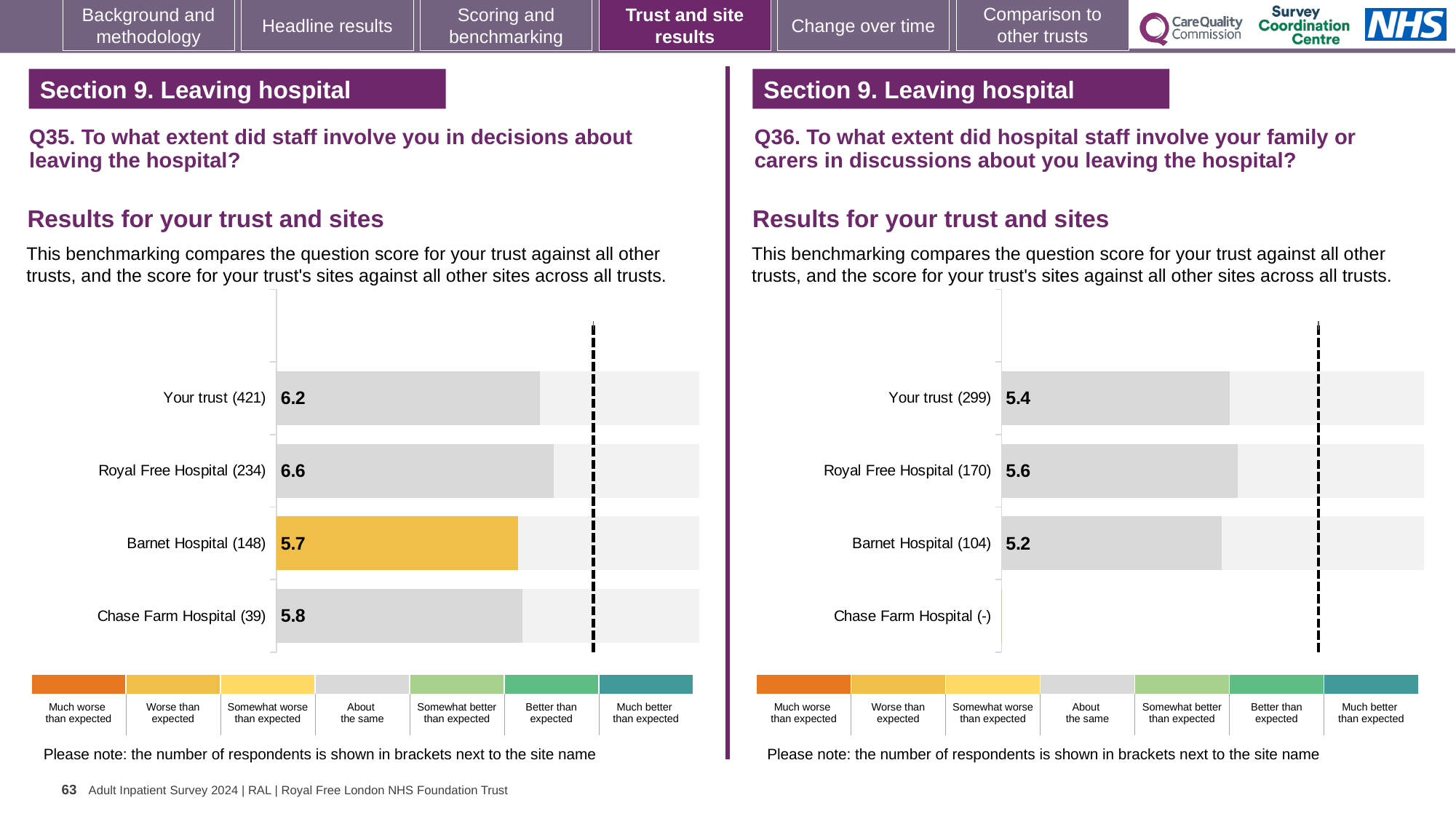
In the Q36 chart on the right, what is the score for Royal Free Hospital? 5.6 In the Q36 chart on the right, how many respondents are shown in brackets for Your trust? 299 In the Q35 chart on the left, what is the score for Barnet Hospital? 5.7 In the Q35 chart on the left, what is the difference between the scores for Royal Free Hospital and Barnet Hospital? 0.9 In the Q36 chart on the right, which of the plotted sites or trust has the lowest score? Barnet Hospital What type of chart is used in the Q35 chart on the left? Bar chart In the Q35 chart on the left, which has the larger score, Chase Farm Hospital or Barnet Hospital? Chase Farm Hospital In the Q35 chart on the left, which site or trust has the lowest score? Barnet Hospital In the Q35 chart on the left, what is the score for Your trust? 6.2 In the Q35 chart on the left, which site or trust has the highest score? Royal Free Hospital In the Q36 chart on the right, what is the difference between the scores for Your trust and Barnet Hospital? 0.2 In the Q36 chart on the right, what is the score for Barnet Hospital? 5.2